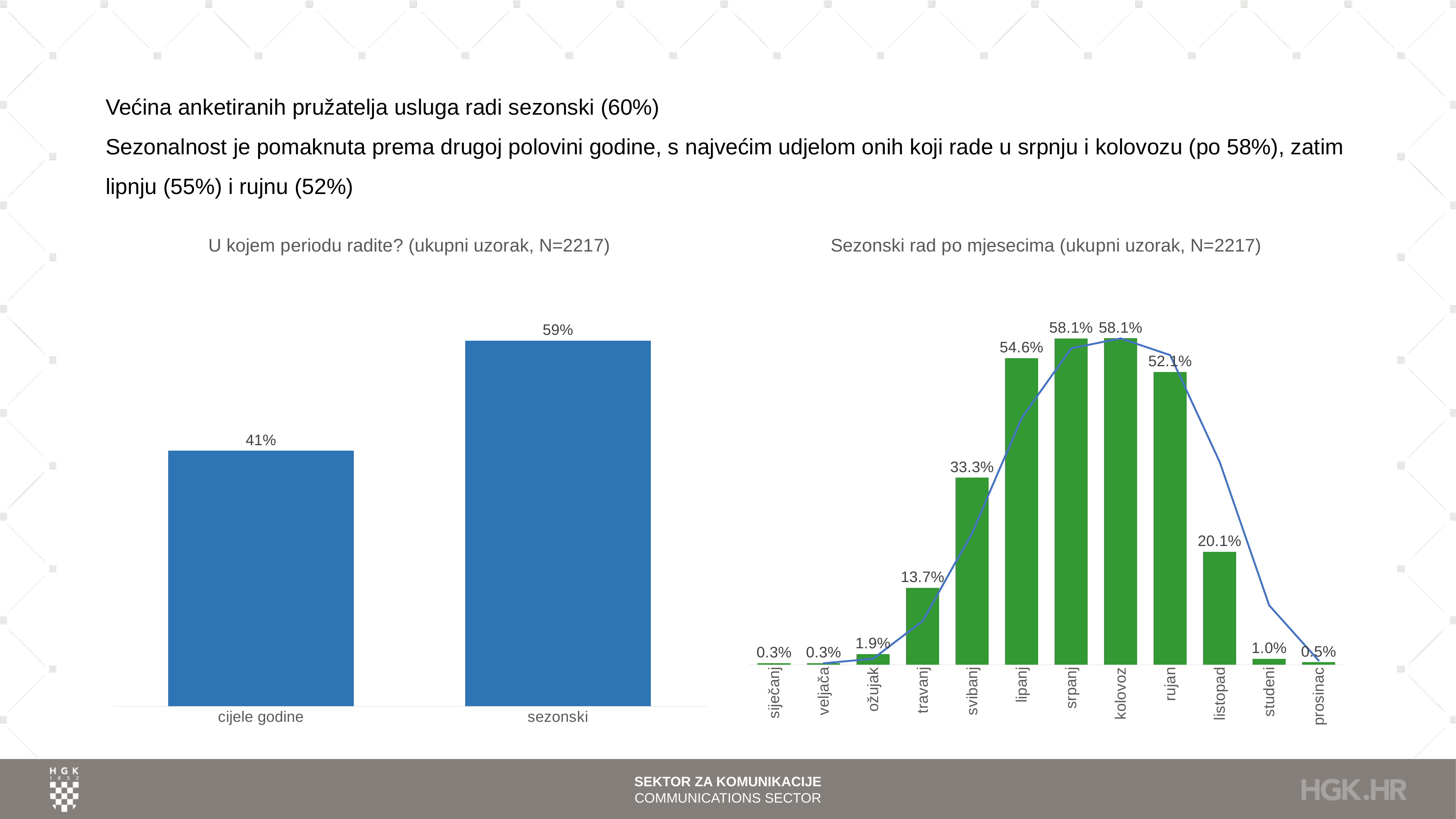
What type of chart is the one titled 'U kojem periodu radite? (ukupni uzorak, N=2217)'? bar chart In the chart titled 'U kojem periodu radite? (ukupni uzorak, N=2217)', what is the value for 'sezonski'? 59% In the chart titled 'Sezonski rad po mjesecima (ukupni uzorak, N=2217)', which is larger, 'svibanj' or 'rujan'? rujan In the chart titled 'U kojem periodu radite? (ukupni uzorak, N=2217)', what is the value for 'cijele godine'? 41% In the chart titled 'U kojem periodu radite? (ukupni uzorak, N=2217)', what is the difference between 'sezonski' and 'cijele godine'? 18% In the chart titled 'Sezonski rad po mjesecima (ukupni uzorak, N=2217)', how many months are shown on the x axis? 12 In the chart titled 'Sezonski rad po mjesecima (ukupni uzorak, N=2217)', which month has the lowest value? siječanj and veljača (0.3%) In the chart titled 'Sezonski rad po mjesecima (ukupni uzorak, N=2217)', what is the value for 'lipanj'? 54.6% In the chart titled 'U kojem periodu radite? (ukupni uzorak, N=2217)', how many categories are shown? 2 In the chart titled 'Sezonski rad po mjesecima (ukupni uzorak, N=2217)', what is the difference between 'rujan' and 'listopad'? 32.0% In the chart titled 'Sezonski rad po mjesecima (ukupni uzorak, N=2217)', what is the value for 'travanj'? 13.7% In the chart titled 'Sezonski rad po mjesecima (ukupni uzorak, N=2217)', what is the value for 'listopad'? 20.1%